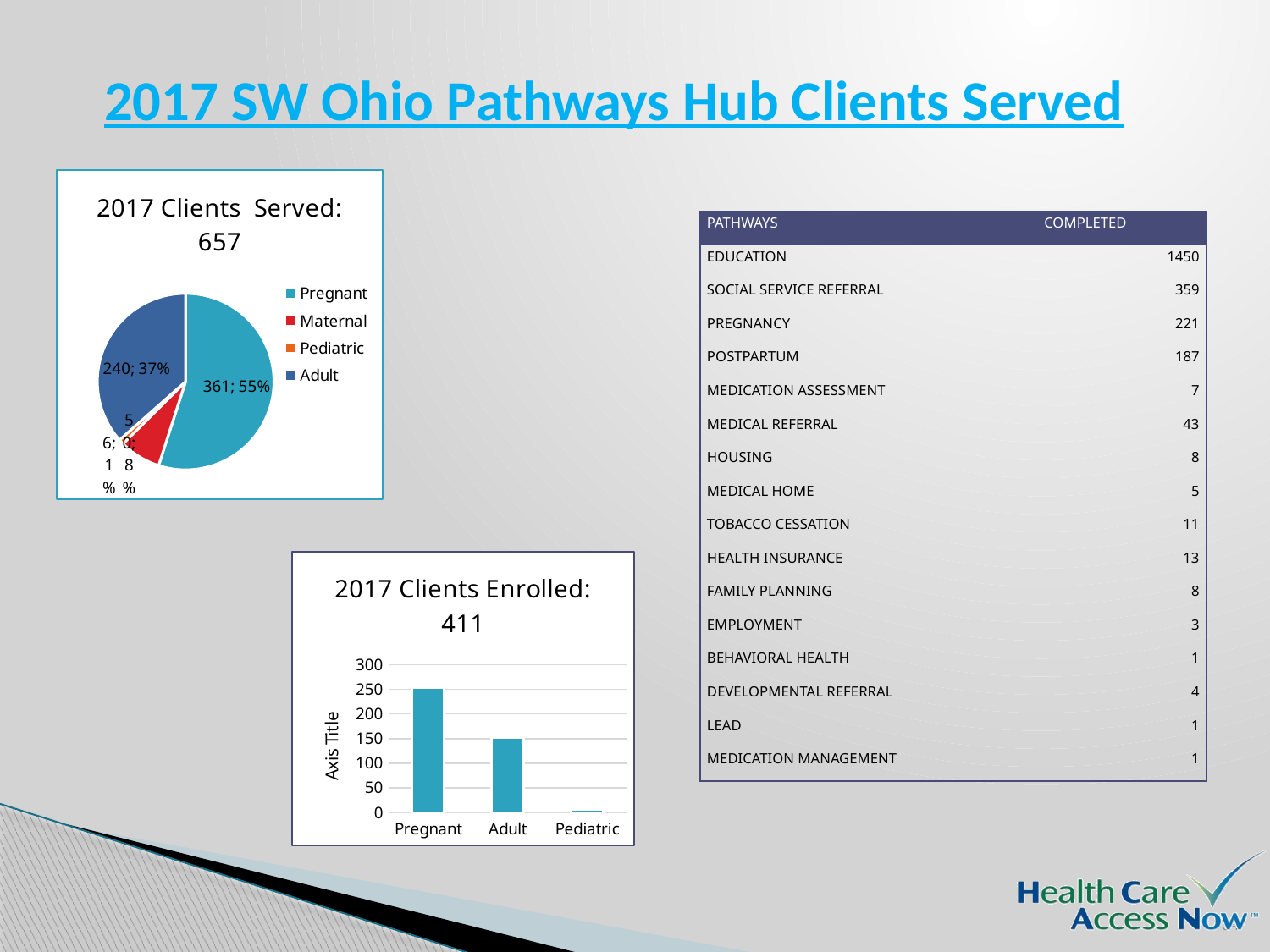
In the bar chart titled "2017 Clients Enrolled: 411", do the bar values rise or fall from left to right along the x axis? fall In the pie chart titled "2017 Clients Served: 657", how many clients are in the Pregnant category? 361 In the bar chart titled "2017 Clients Enrolled: 411", how many categories are shown on the x axis? 3 In the pie chart titled "2017 Clients Served: 657", what is the difference between the Pregnant and Adult counts? 121 In the pie chart titled "2017 Clients Served: 657", what percentage share does the Pregnant slice have? 55% In the pie chart titled "2017 Clients Served: 657", how many clients are in the Adult category? 240 In the pie chart titled "2017 Clients Served: 657", what percentage share does the Adult slice have? 37% In the pie chart titled "2017 Clients Served: 657", how many categories does the legend list? 4 In the bar chart titled "2017 Clients Enrolled: 411", is the value for Adult greater or less than 200? less What kind of chart is the "2017 Clients Enrolled: 411" chart? bar chart In the bar chart titled "2017 Clients Enrolled: 411", which category has the tallest bar? Pregnant In the pie chart titled "2017 Clients Served: 657", which category has the largest slice? Pregnant